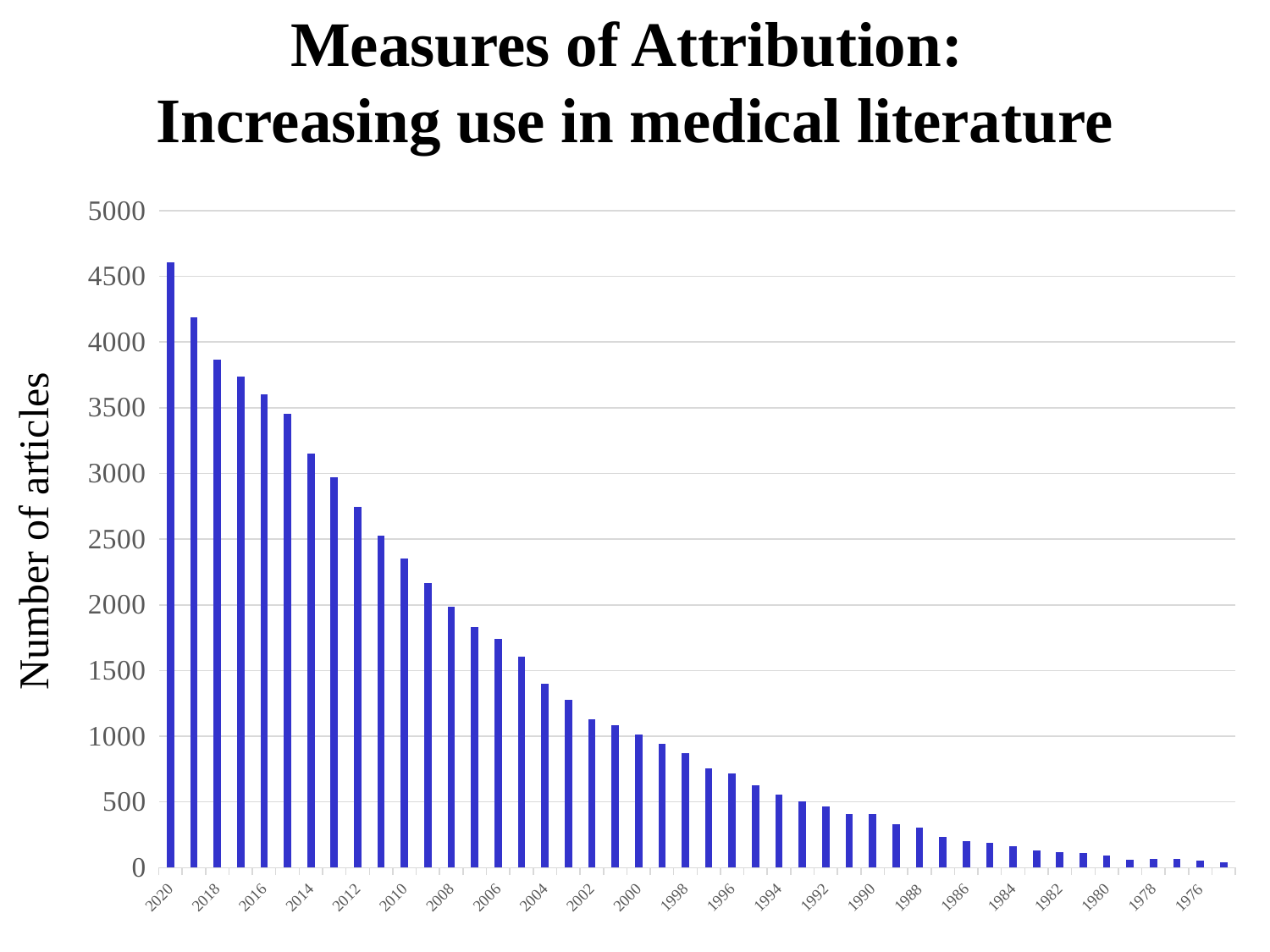
Which year has the highest number of articles? 2020 Do the values rise or fall moving from left (2020) to right (1976) along the x axis? fall Is the number of articles for 2020 greater or less than 4500? greater Is the number of articles for 1990 greater or less than 500? less Which year has more articles, 2012 or 2002? 2012 Is the number of articles for 1998 greater or less than 1000? less What is the label of the y axis? Number of articles What kind of chart is shown on the slide? bar chart